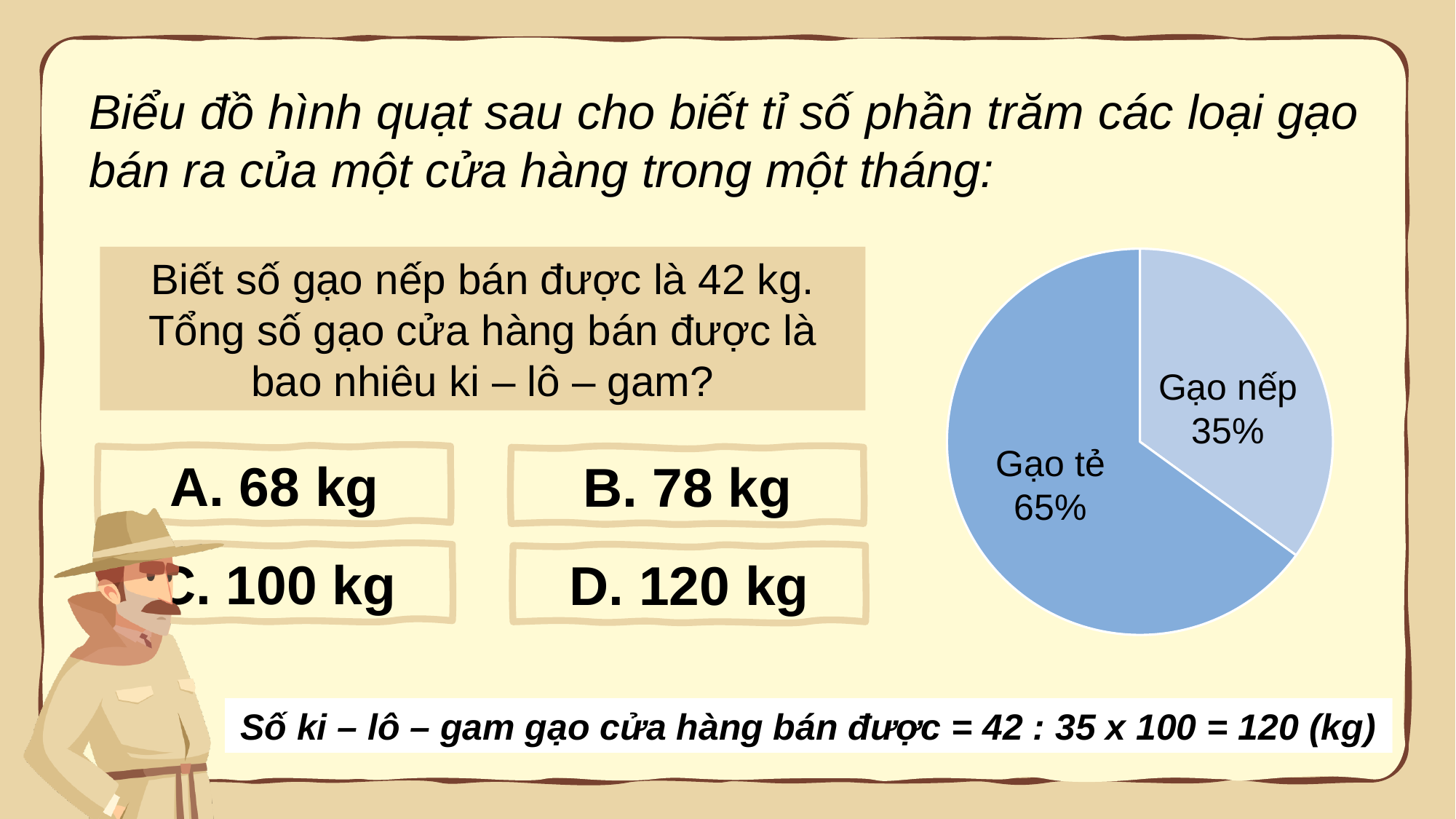
Which category has the largest share of the pie chart? Gạo tẻ What share of the pie does the Gạo nếp slice represent? 35% Is the share for Gạo tẻ greater or less than 50%? greater Which is larger in the pie chart, Gạo nếp or Gạo tẻ? Gạo tẻ What is the difference in percentage points between Gạo tẻ and Gạo nếp? 30% What percentage does the pie chart show for Gạo nếp? 35% What kind of chart is shown on the slide? pie chart What do the two slices of the pie chart add up to? 100% Which category has the smallest share of the pie chart? Gạo nếp How many slices does the pie chart have? 2 What colour is the Gạo tẻ slice compared with the Gạo nếp slice? darker blue What percentage does the pie chart show for Gạo tẻ? 65%